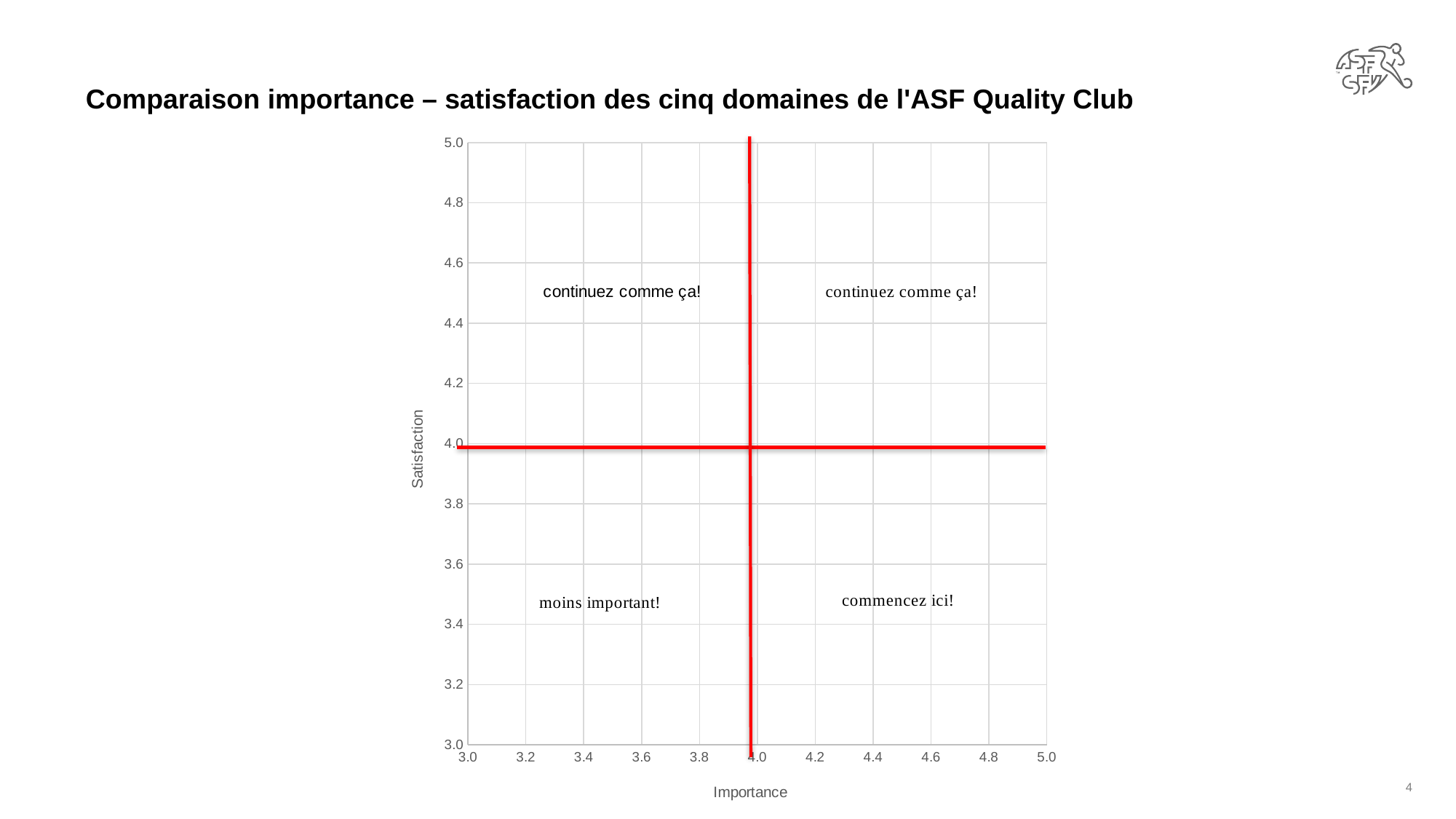
At which value on the Satisfaction axis does the horizontal red line cross? 4.0 What label is on the horizontal axis of the chart? Importance What is the lowest value shown on the Satisfaction axis? 3.0 At which value on the Importance axis does the vertical red line cross? 4.0 What is the title of the chart on the slide? Comparaison importance – satisfaction des cinq domaines de l'ASF Quality Club What is the highest value shown on the Importance axis? 5.0